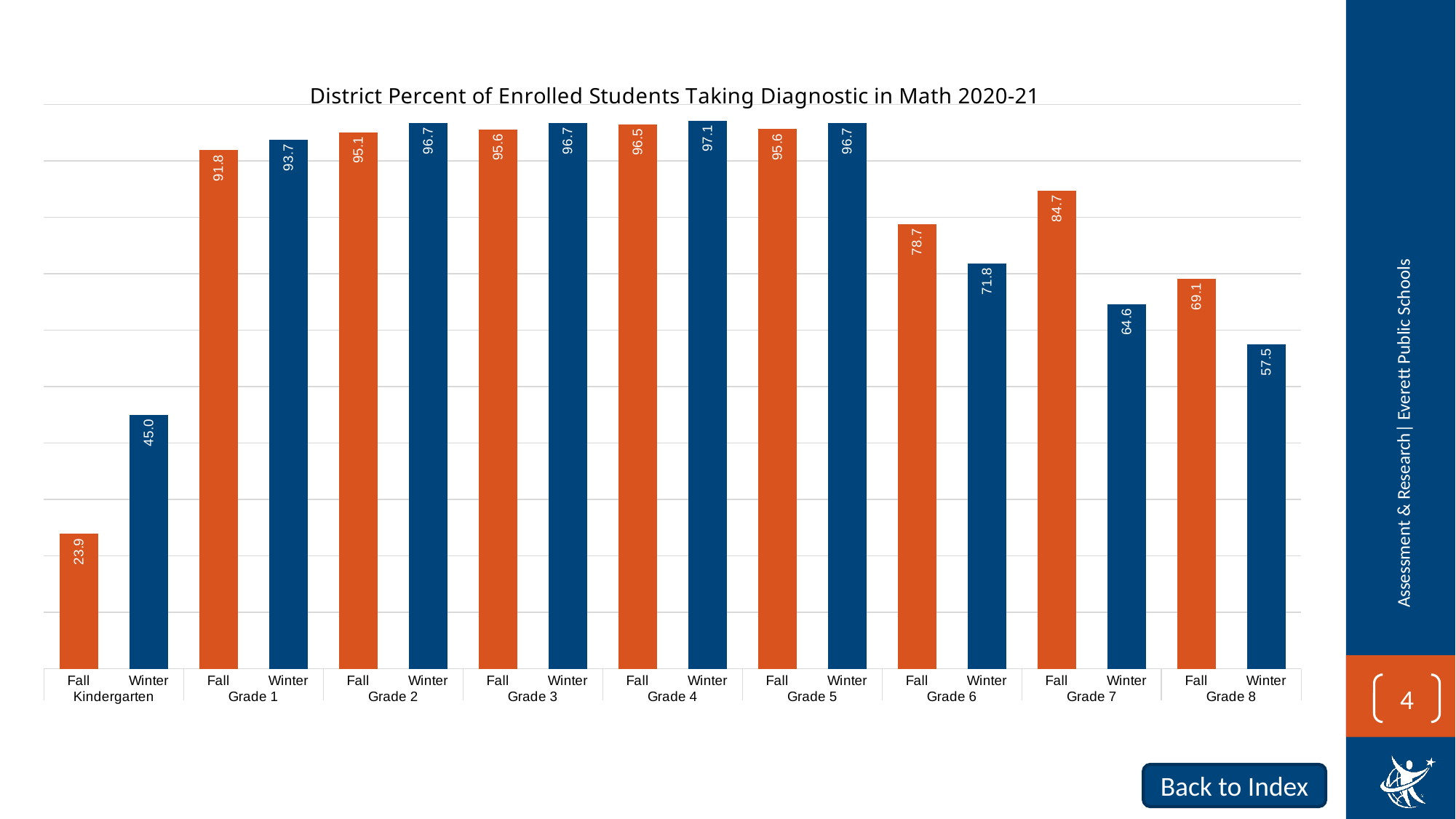
How many grade-level groups are shown on the x axis? 9 What is the Fall value for Grade 7? 84.7 What is the difference between the Winter and Fall values for Kindergarten? 21.1 What kind of chart is shown on the slide? Bar chart Which bar has the lowest value on the chart? Kindergarten Fall Which is larger, the Fall value for Grade 6 or the Winter value for Grade 6? Fall What is the difference between the Fall and Winter values for Grade 8? 11.6 What is the title of the chart? District Percent of Enrolled Students Taking Diagnostic in Math 2020-21 What is the Fall value for Kindergarten? 23.9 Which bar has the highest value on the chart? Grade 4 Winter Which is larger, the Winter value for Grade 1 or the Fall value for Grade 2? Fall for Grade 2 What is the Winter value for Grade 4? 97.1